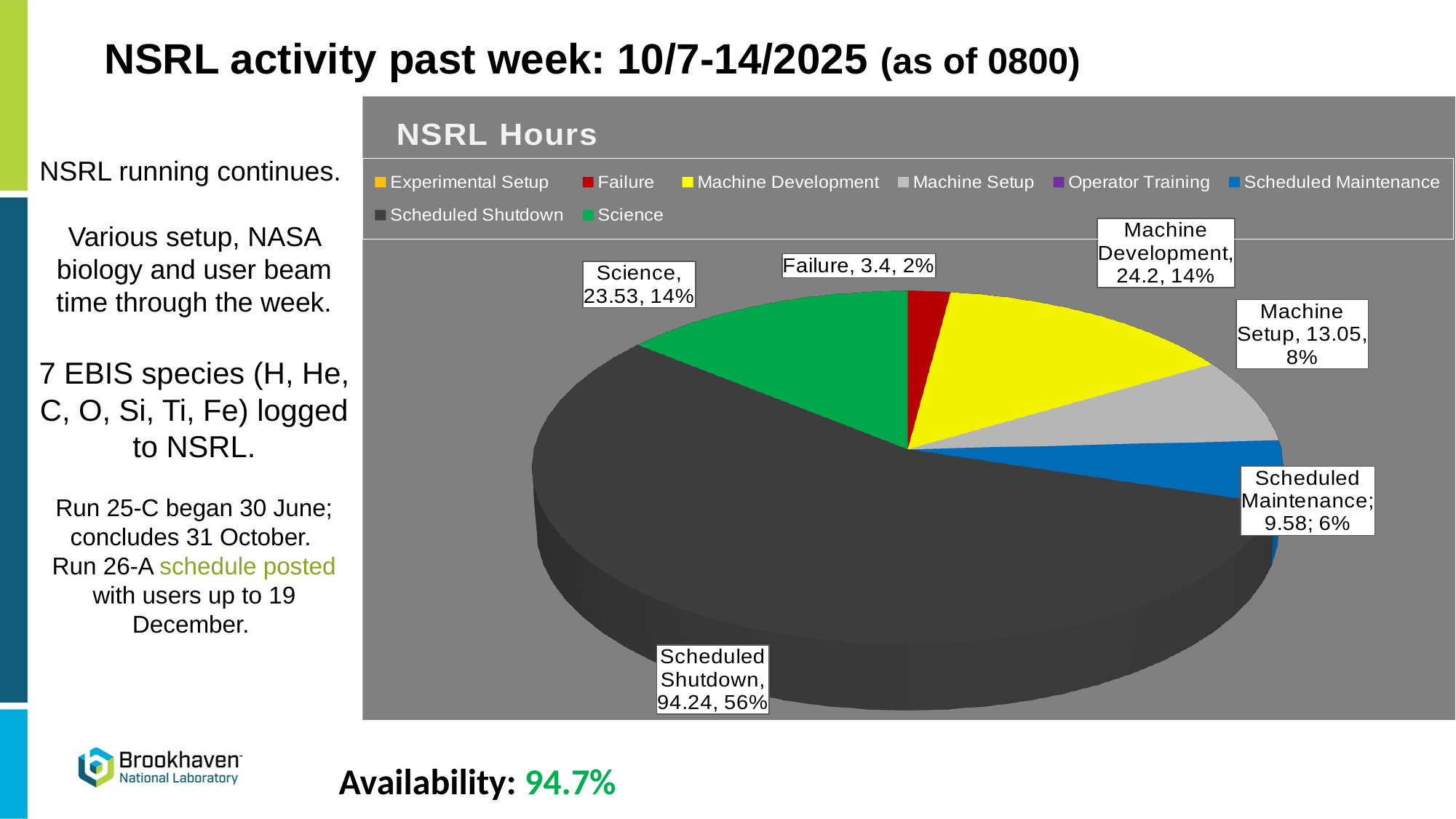
How many hours are shown for Science? 23.53 What share of the pie does Scheduled Shutdown represent? 56% What is the difference in hours between Machine Setup and Scheduled Maintenance? 3.47 How many entries does the chart legend list? 8 How many hours are shown for Scheduled Shutdown? 94.24 Which category has the largest slice of the pie? Scheduled Shutdown Which has more hours, Machine Development or Science? Machine Development Which labeled slice has the fewest hours? Failure What is the title of the chart? NSRL Hours How many hours are shown for Machine Setup? 13.05 What share of the pie does Scheduled Maintenance represent? 6% What type of chart is shown on the slide? pie chart